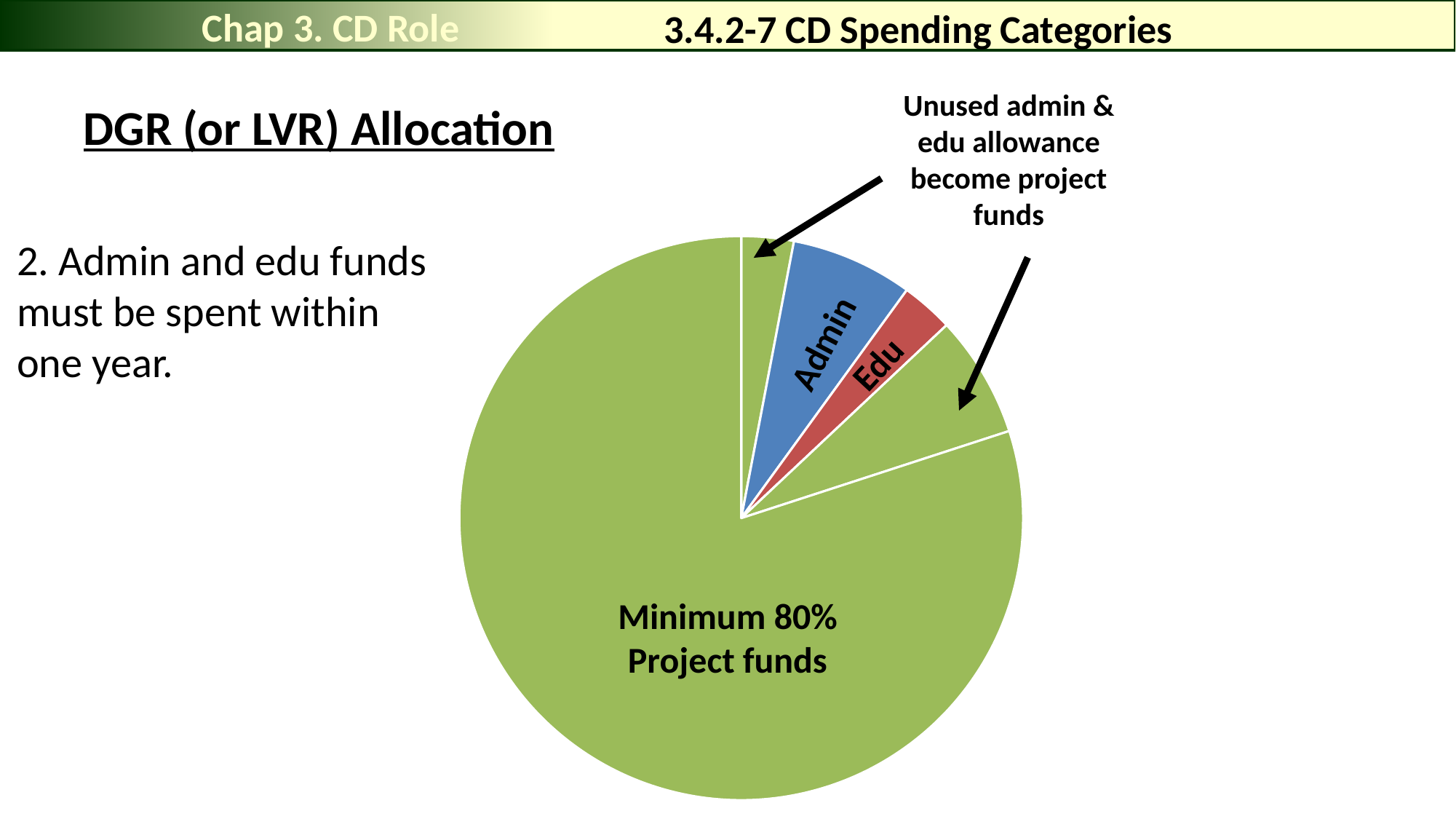
According to the annotation on the pie chart, what do unused admin and edu allowances become? Project funds Is the Project funds slice greater or less than 50% of the pie? greater Which slice is smaller in the pie chart, Admin or Edu? Edu How many slices does the pie chart have? 5 What kind of chart is shown on the slide? Pie chart Which slice is larger in the pie chart, Admin or Edu? Admin What colour is the Admin slice in the pie chart? Blue What minimum share is labelled on the Project funds slice of the pie chart? Minimum 80% Which slice of the pie chart is the largest? Project funds What is the title of the chart on the slide? DGR (or LVR) Allocation